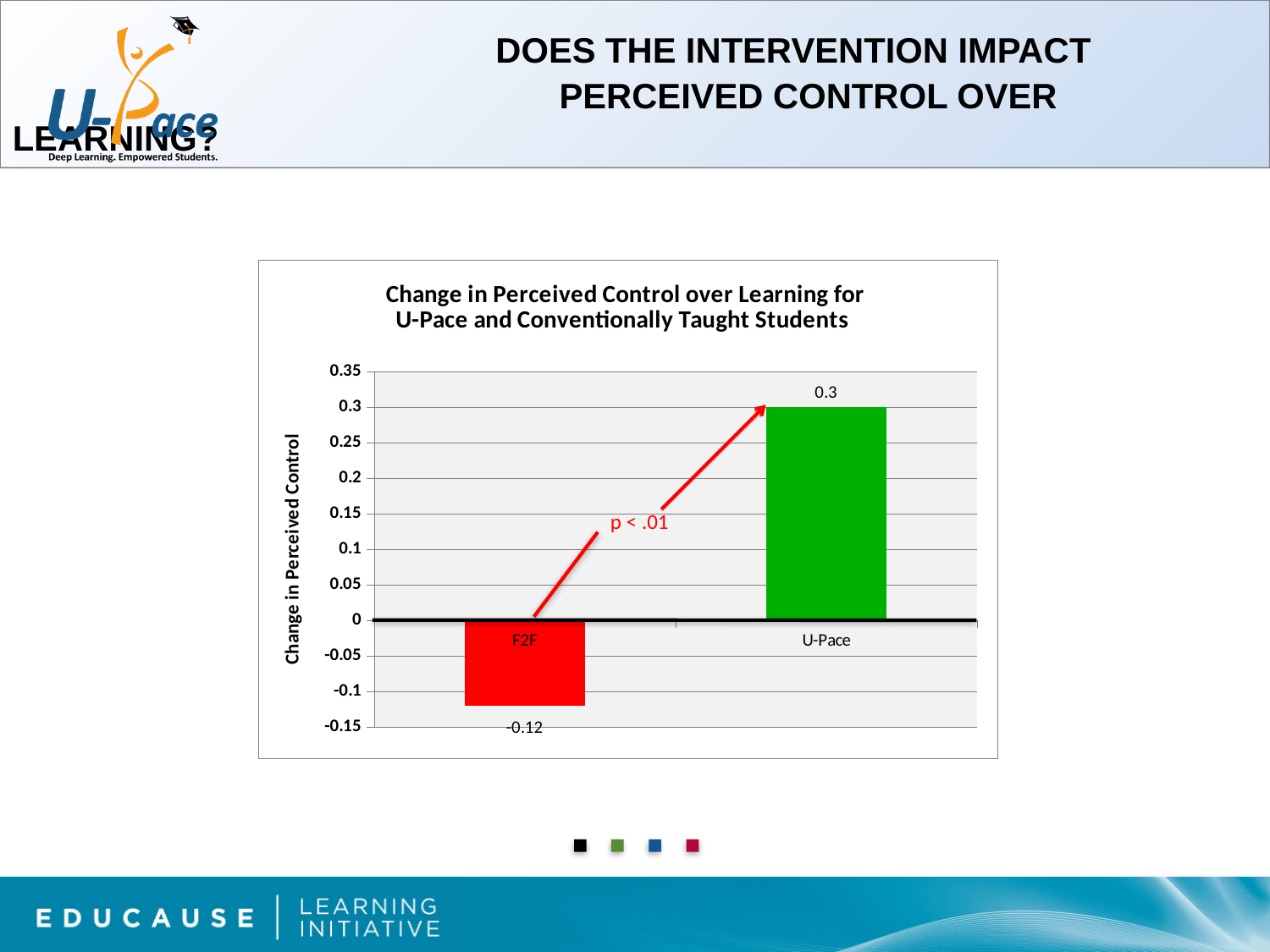
What kind of chart is shown? bar chart What is the label of the y axis? Change in Perceived Control Which category has the lowest change in perceived control? F2F What is the difference between the U-Pace value and the F2F value? 0.42 What is the title of the chart? Change in Perceived Control over Learning for U-Pace and Conventionally Taught Students What is the value for U-Pace? 0.3 Which category has the highest change in perceived control? U-Pace Which is larger, the value for F2F or the value for U-Pace? U-Pace Is the value for F2F greater or less than 0? less Is the value for U-Pace greater or less than 0.25? greater What is the value for F2F? -0.12 How many categories are shown on the x axis? 2